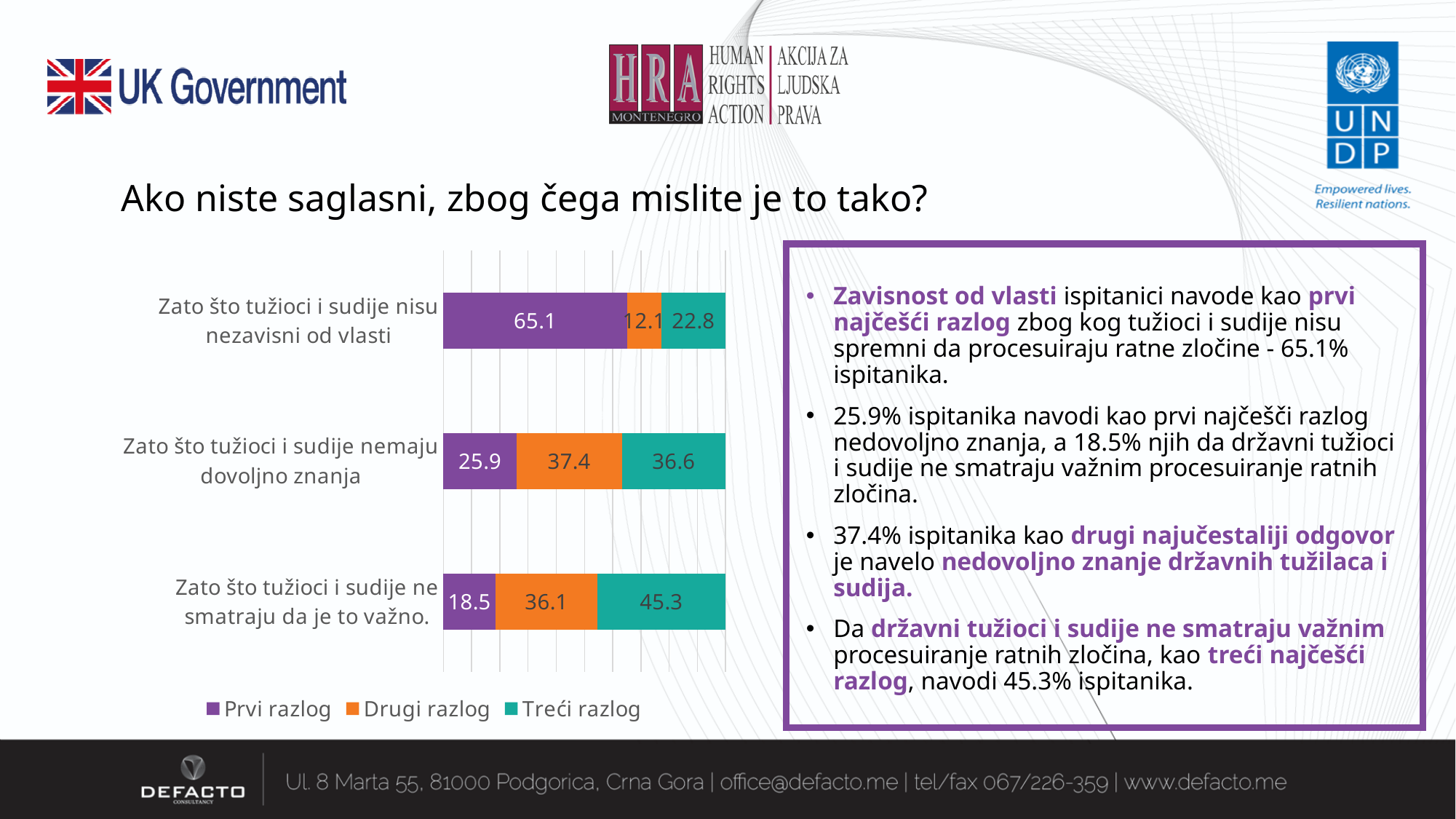
What is the 'Treći razlog' value for 'Zato što tužioci i sudije ne smatraju da je to važno'? 45.3 Which colour represents the 'Treći razlog' series in the chart? Teal How many series does the chart legend list? 3 How many categories are plotted in the chart? 3 Which category has the highest 'Prvi razlog' value? Zato što tužioci i sudije nisu nezavisni od vlasti Which category has the lowest 'Treći razlog' value? Zato što tužioci i sudije nisu nezavisni od vlasti What is the difference between the 'Prvi razlog' values for 'Zato što tužioci i sudije nisu nezavisni od vlasti' and 'Zato što tužioci i sudije nemaju dovoljno znanja'? 39.2 What is the 'Drugi razlog' value for 'Zato što tužioci i sudije nemaju dovoljno znanja'? 37.4 What is the total of the stacked bar for 'Zato što tužioci i sudije nisu nezavisni od vlasti'? 100.0 What type of chart is shown on the slide? Stacked bar chart What is the 'Prvi razlog' value for 'Zato što tužioci i sudije nisu nezavisni od vlasti'? 65.1 Which is larger: the 'Drugi razlog' value for 'Zato što tužioci i sudije nemaju dovoljno znanja' or for 'Zato što tužioci i sudije ne smatraju da je to važno'? Zato što tužioci i sudije nemaju dovoljno znanja